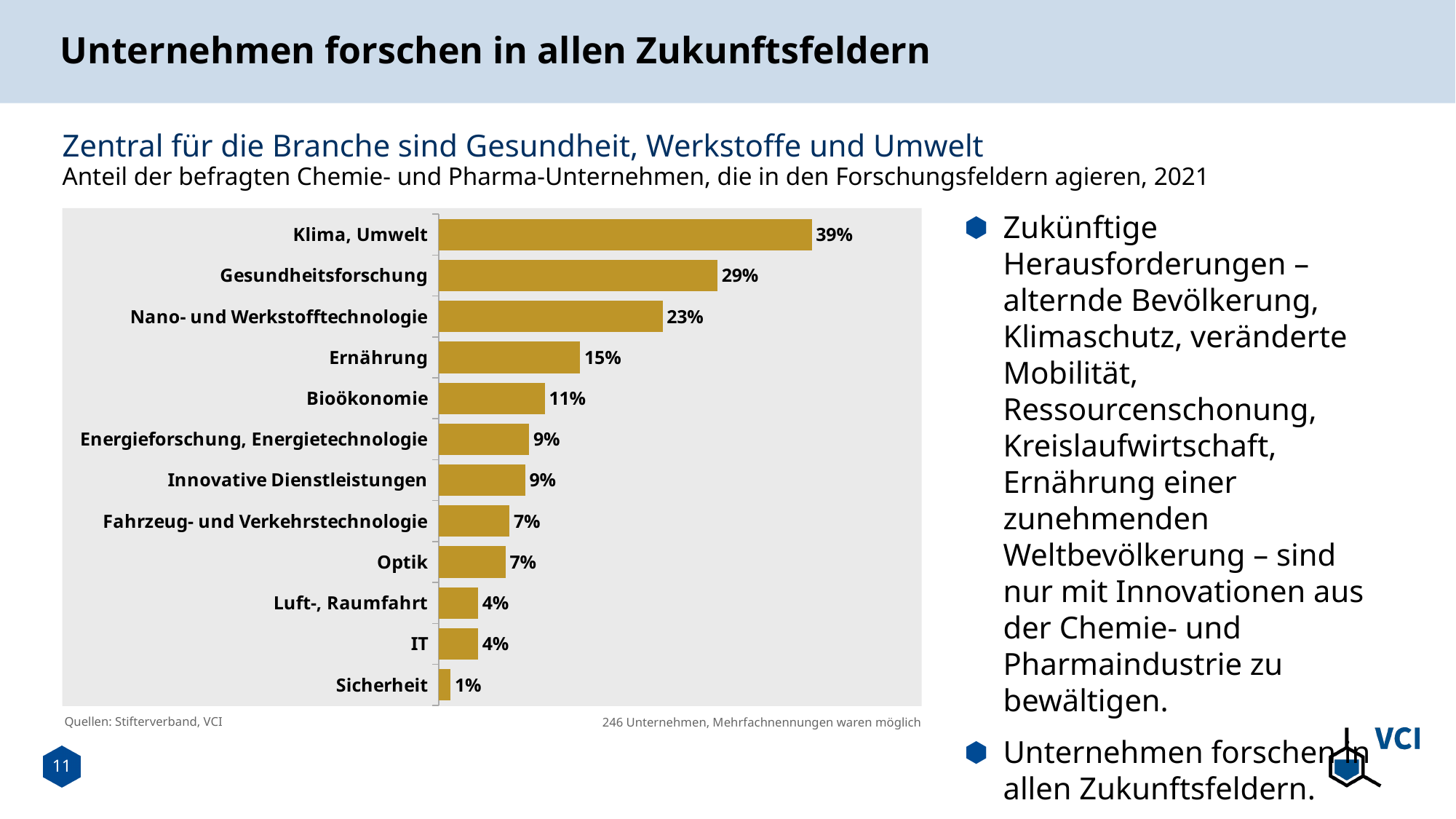
What colour are the bars in the chart? Gold Which is larger, the value for Gesundheitsforschung or the value for Nano- und Werkstofftechnologie? Gesundheitsforschung Which research field has the highest share of companies? Klima, Umwelt What is the difference between the values for Ernährung and Bioökonomie? 4% Which research field has the lowest share of companies? Sicherheit What is the value for Klima, Umwelt? 39% What kind of chart is shown on the slide? Bar chart What is the value for Luft-, Raumfahrt? 4% What is the value for Nano- und Werkstofftechnologie? 23% What is the difference between the values for Klima, Umwelt and Gesundheitsforschung? 10% How many research fields are shown in the chart? 12 What is the value for Bioökonomie? 11%